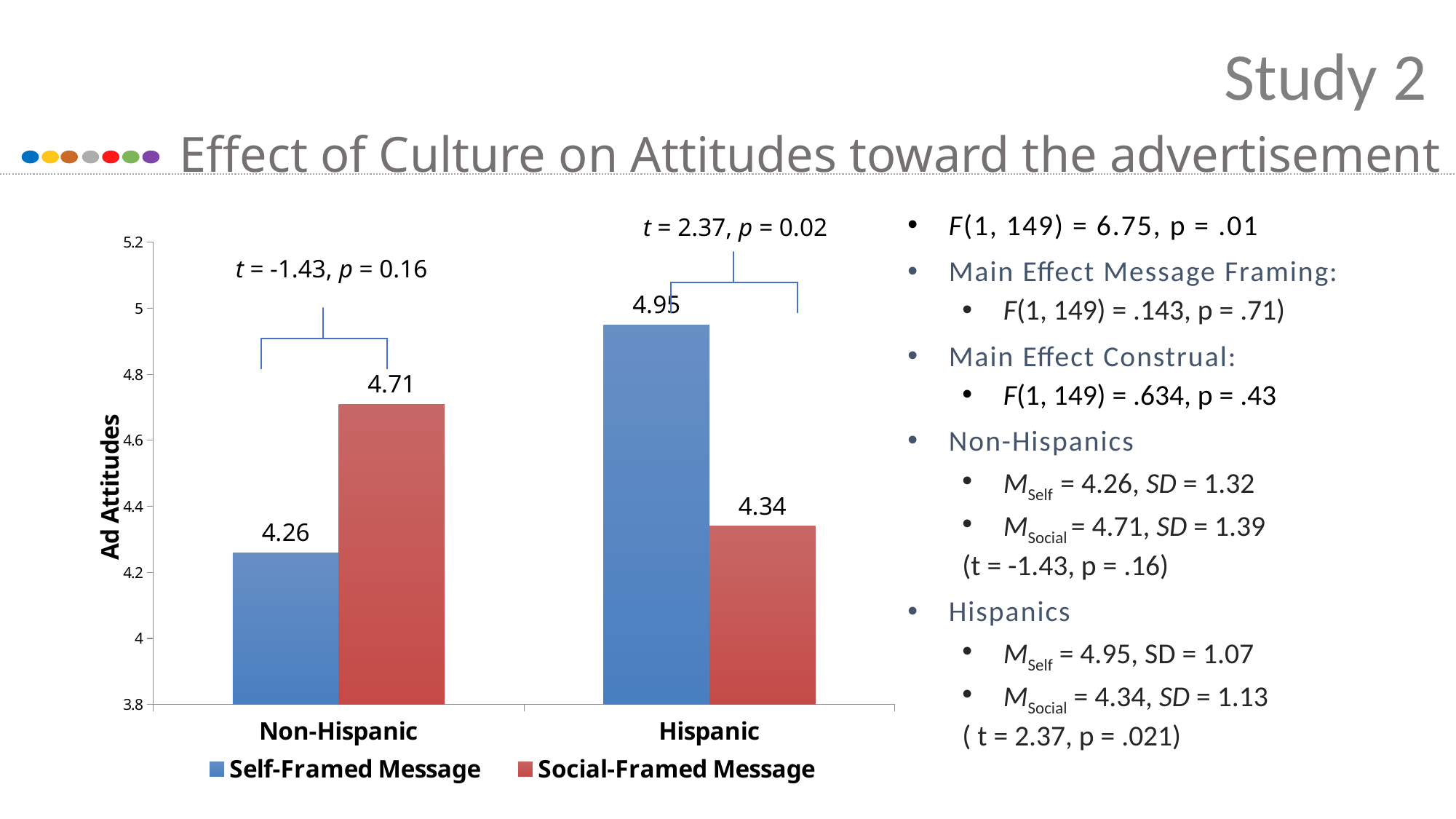
What is the Ad Attitudes value for the Self-Framed Message in the Non-Hispanic group? 4.26 How many categories are shown on the x axis? 2 What is the Ad Attitudes value for the Social-Framed Message in the Hispanic group? 4.34 Is the value for the Self-Framed Message in the Hispanic group greater or less than 4.8? greater What is the difference between the Self-Framed and Social-Framed Message values in the Hispanic group? 0.61 In the Non-Hispanic group, which message type has the larger Ad Attitudes value? Social-Framed Message What kind of chart is shown on the slide? Bar chart How many series does the legend list? 2 What is the Ad Attitudes value for the Social-Framed Message in the Non-Hispanic group? 4.71 What is the difference between the Social-Framed and Self-Framed Message values in the Non-Hispanic group? 0.45 Which bar has the highest Ad Attitudes value? Self-Framed Message, Hispanic Which bar has the lowest Ad Attitudes value? Self-Framed Message, Non-Hispanic